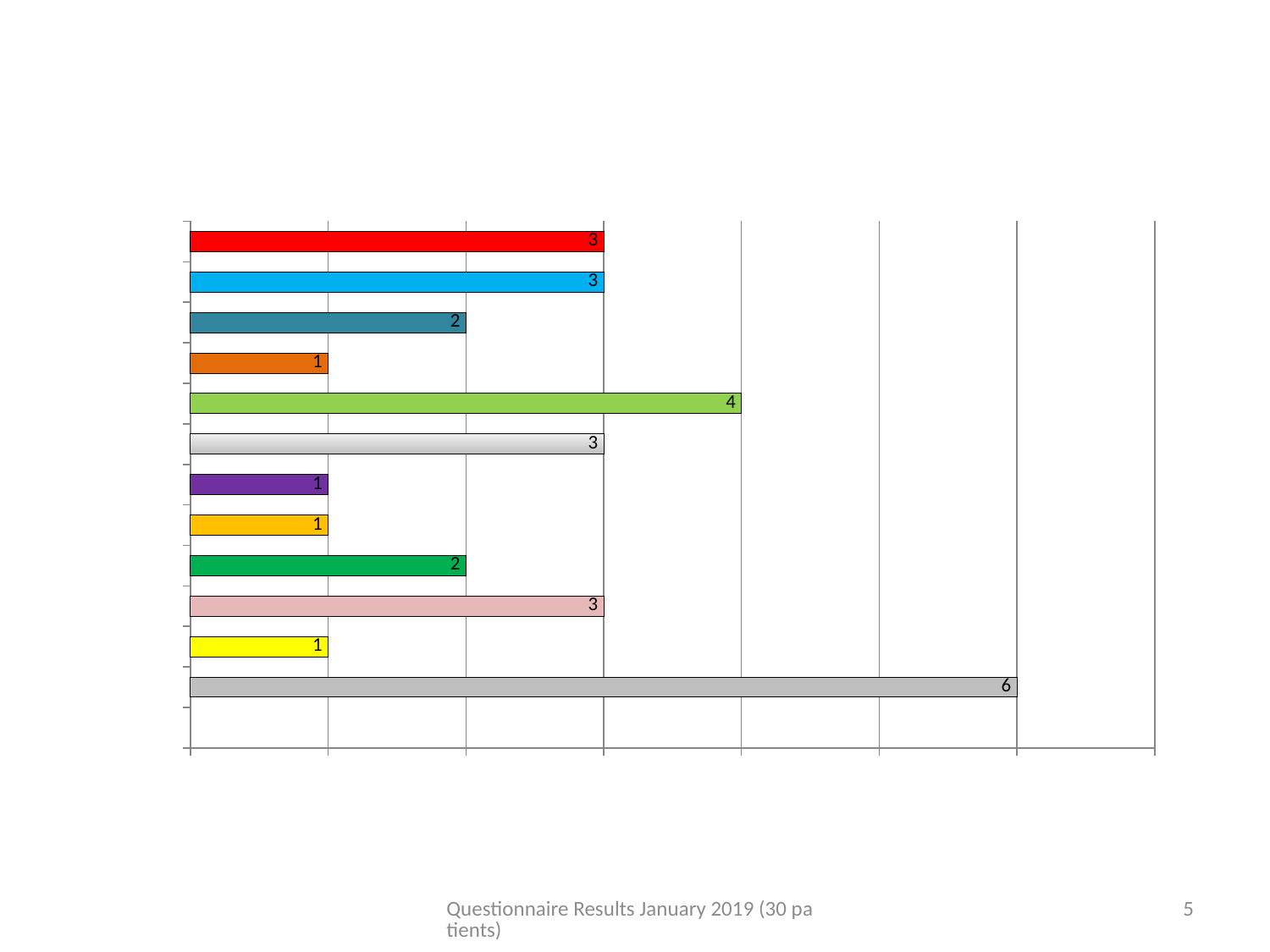
What is the value of the light green bar? 4 What is the value of the pink bar? 3 What is the value of the dark green bar? 2 What is the difference between the grey bar at the bottom (6) and the light green bar (4)? 2 What is the value of the longest bar (the grey bar at the bottom)? 6 What is the value of the purple bar? 1 Which is larger, the light green bar or the red bar? the light green bar How many bars are plotted in the chart? 12 What is the difference between the light blue bar and the orange bar? 2 What is the value of the red bar at the top of the chart? 3 What text appears in the footer of the slide? Questionnaire Results January 2019 (30 patients) What kind of chart is shown on the slide? bar chart